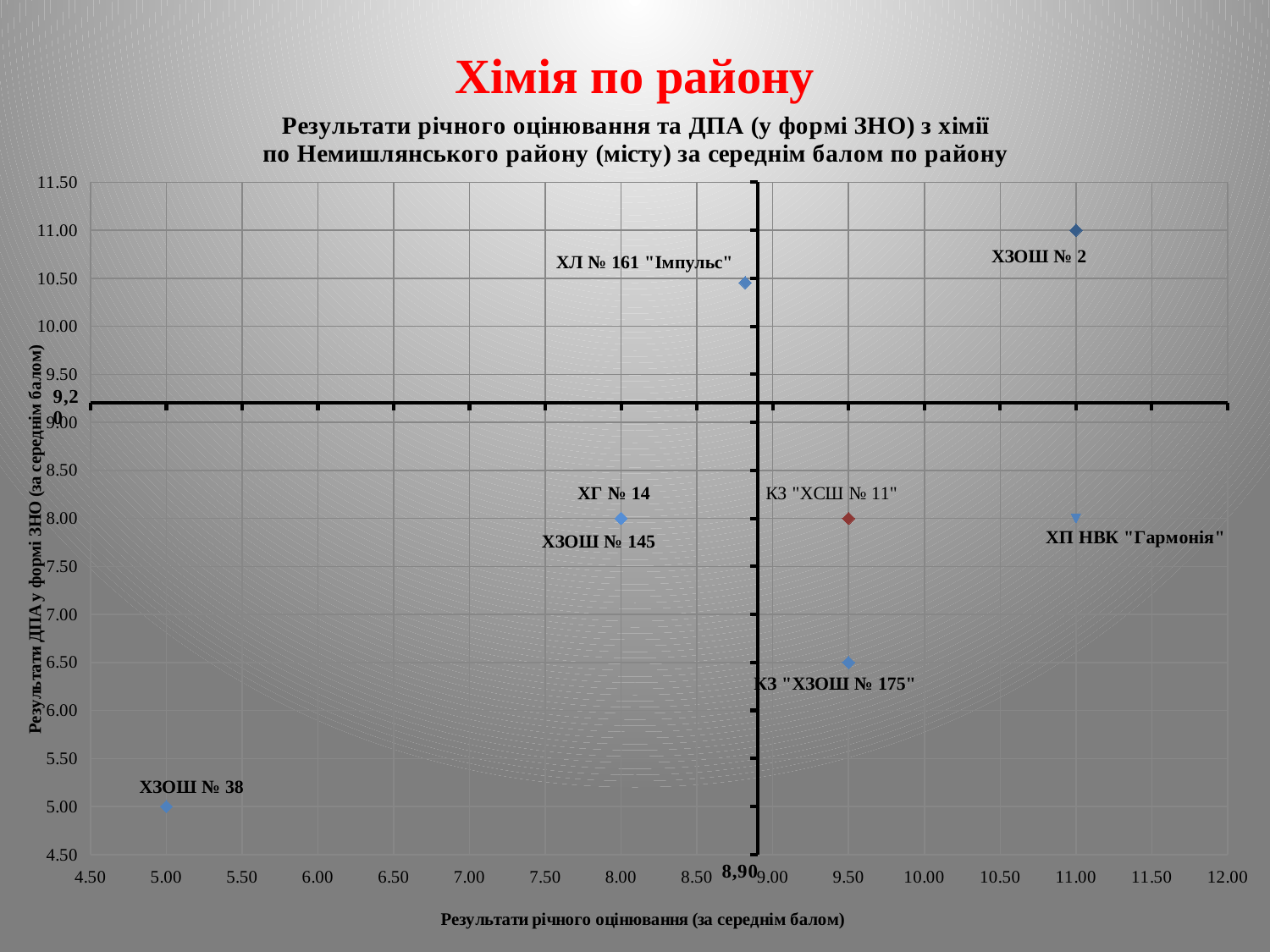
What value is marked on the vertical axis where the bold horizontal reference line crosses it? 9,20 Is the vertical-axis value for ХЛ № 161 "Імпульс" greater or less than 10.00? greater What is the title of the horizontal axis? Результати річного оцінювання (за середнім балом) What is the annual assessment result on the horizontal axis for ХЗОШ № 2? 11.00 What is the difference between the vertical-axis values of ХЗОШ № 2 and ХЗОШ № 38? 6.00 What is the ДПА (ЗНО) result on the vertical axis for ХЗОШ № 38? 5.00 Which school has the highest ДПА (ЗНО) result on the vertical axis? ХЗОШ № 2 Which has the higher ДПА (ЗНО) result on the vertical axis, КЗ "ХСШ № 11" or КЗ "ХЗОШ № 175"? КЗ "ХСШ № 11" What kind of chart is shown on the slide? scatter chart Is the horizontal-axis value for ХЛ № 161 "Імпульс" greater or less than 9.00? less What is the ДПА (ЗНО) result on the vertical axis for КЗ "ХЗОШ № 175"? 6.50 Which school has the lowest annual assessment result on the horizontal axis? ХЗОШ № 38